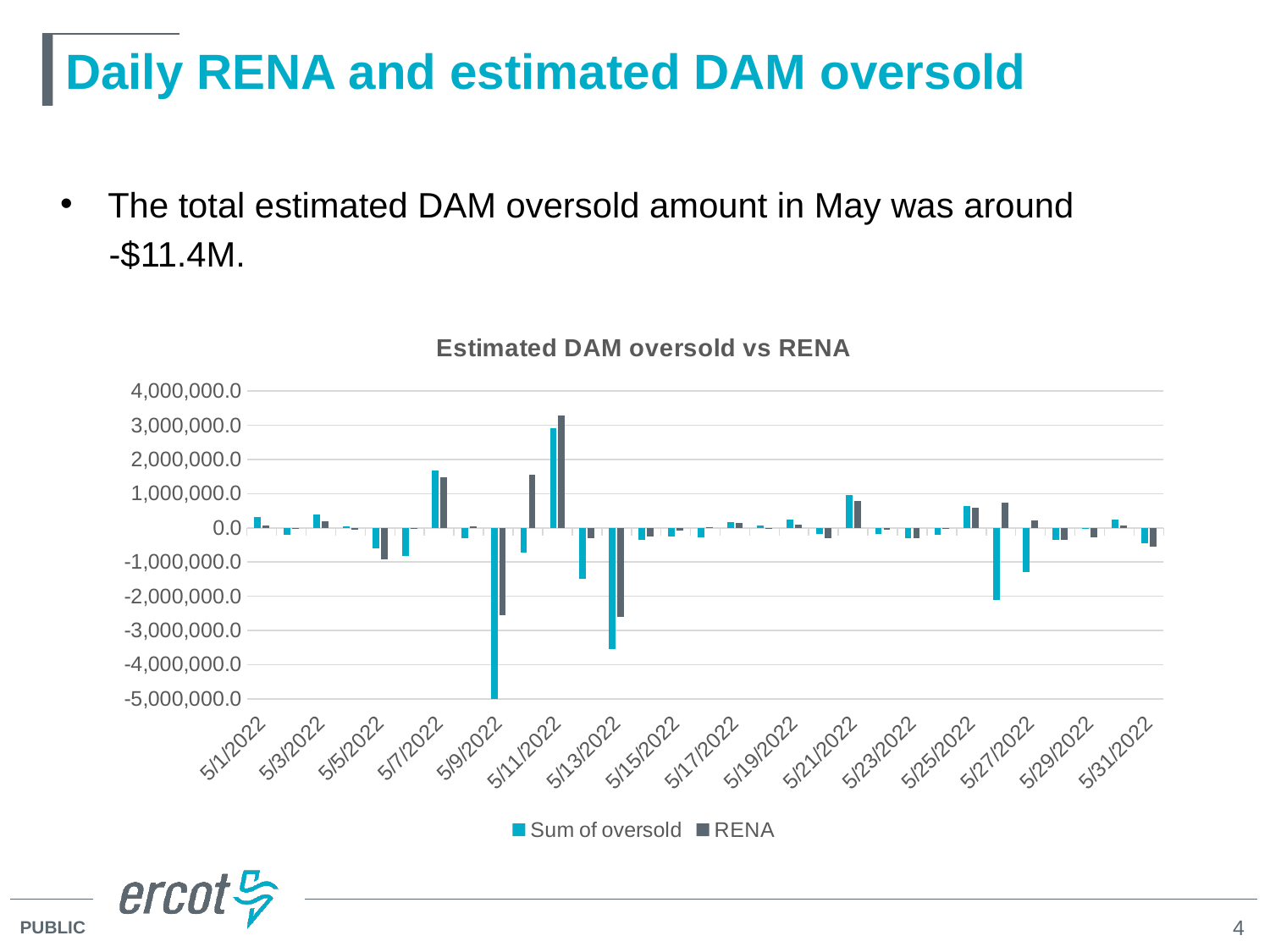
On which date is the RENA value the highest? 5/11/2022 What type of chart is shown on the slide? Bar chart Is the RENA value on 5/11/2022 greater or less than 3,000,000.0? greater What are the two series named in the chart legend? Sum of oversold and RENA What is the title of the chart? Estimated DAM oversold vs RENA How many date labels are shown on the x axis of the chart? 16 Is the Sum of oversold value on 5/7/2022 greater or less than 1,000,000.0? greater On which date is the Sum of oversold value the highest? 5/11/2022 Is the Sum of oversold value on 5/9/2022 greater or less than -4,000,000.0? less On 5/11/2022, which series has the larger value, Sum of oversold or RENA? RENA How many series does the chart legend list? 2 On which date is the Sum of oversold value the lowest? 5/9/2022